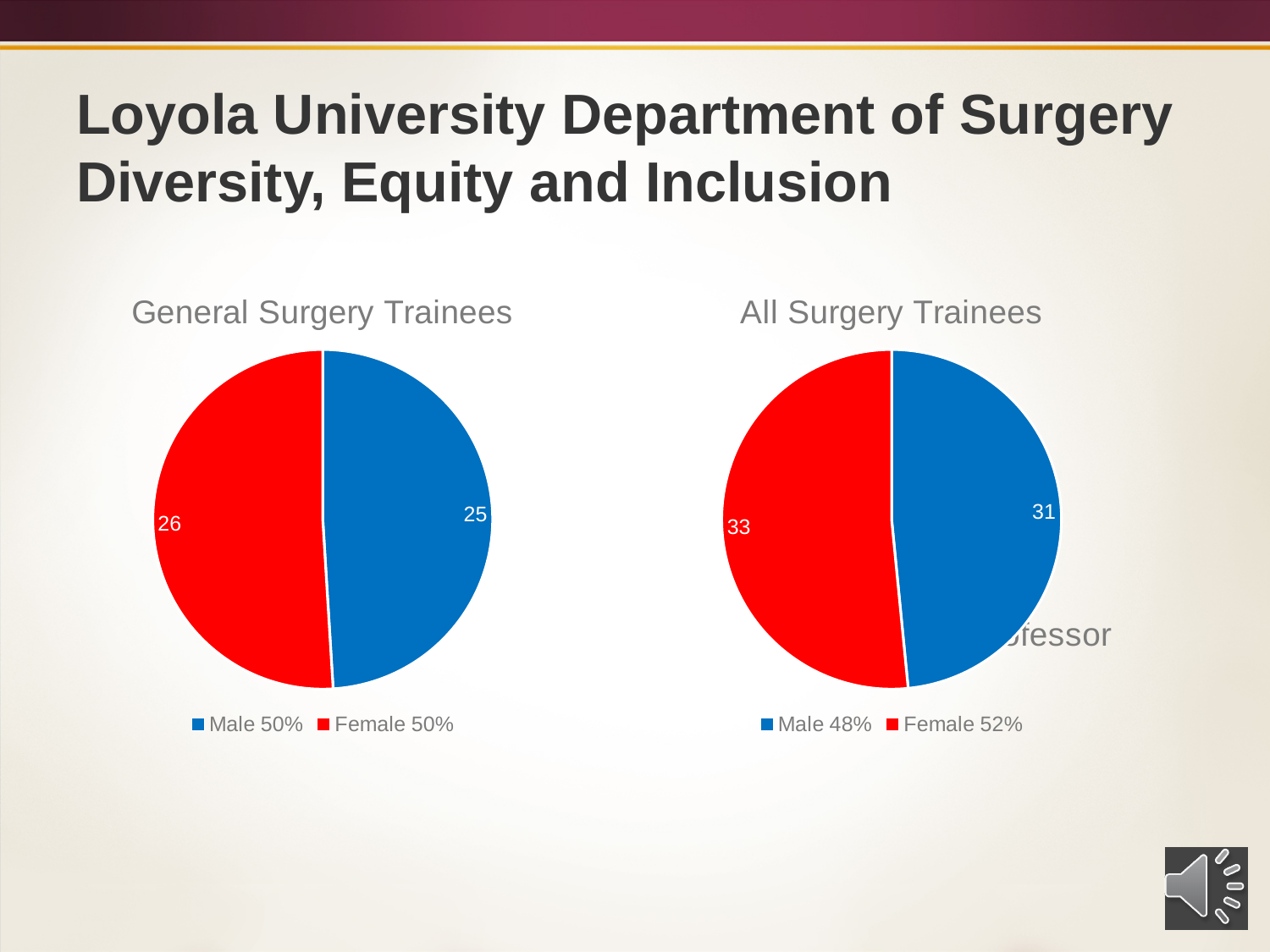
What kind of chart is the All Surgery Trainees chart? Pie chart How many slices does the General Surgery Trainees pie chart have? 2 In the General Surgery Trainees chart, what is the value for Male? 25 In the All Surgery Trainees chart, what is the total of the Male and Female values? 64 In the General Surgery Trainees chart, what is the value for Female? 26 In the General Surgery Trainees chart, what colour is the Female slice? Red In the All Surgery Trainees chart, what is the value for Male? 31 In the All Surgery Trainees chart, what is the value for Female? 33 In the All Surgery Trainees chart, what is the difference between the Female and Male values? 2 In the All Surgery Trainees chart, what share of the pie does Female represent according to the legend? 52% In the General Surgery Trainees chart, what is the total of the Male and Female values? 51 In the General Surgery Trainees chart, what is the difference between the Female and Male values? 1